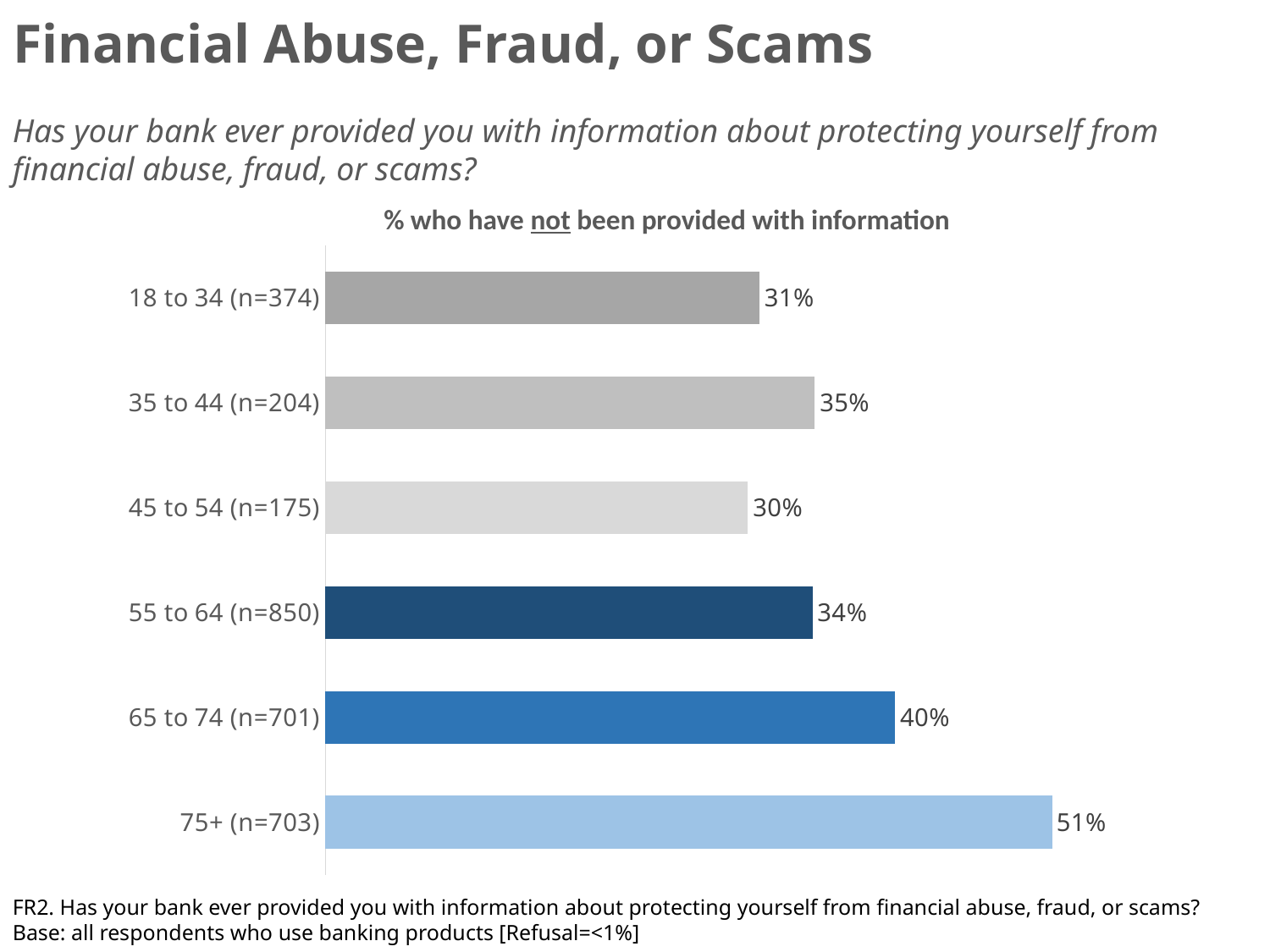
What is the difference between the values for the 75+ group and the 65 to 74 group? 11% What is the title of the chart? % who have not been provided with information Which age group has the highest percentage who have not been provided with information? 75+ (n=703) What is the sample size (n) for the 55 to 64 age group? 850 What is the difference between the values for the 35 to 44 group and the 45 to 54 group? 5% What is the value for the 55 to 64 age group? 34% What percentage of respondents aged 75+ have not been provided with information? 51% Which is larger, the value for 65 to 74 or the value for 55 to 64? 65 to 74 What is the value for the 18 to 34 age group? 31% Which age group has the lowest percentage who have not been provided with information? 45 to 54 (n=175) What kind of chart is shown on the slide? Bar chart How many age groups are shown in the chart? 6